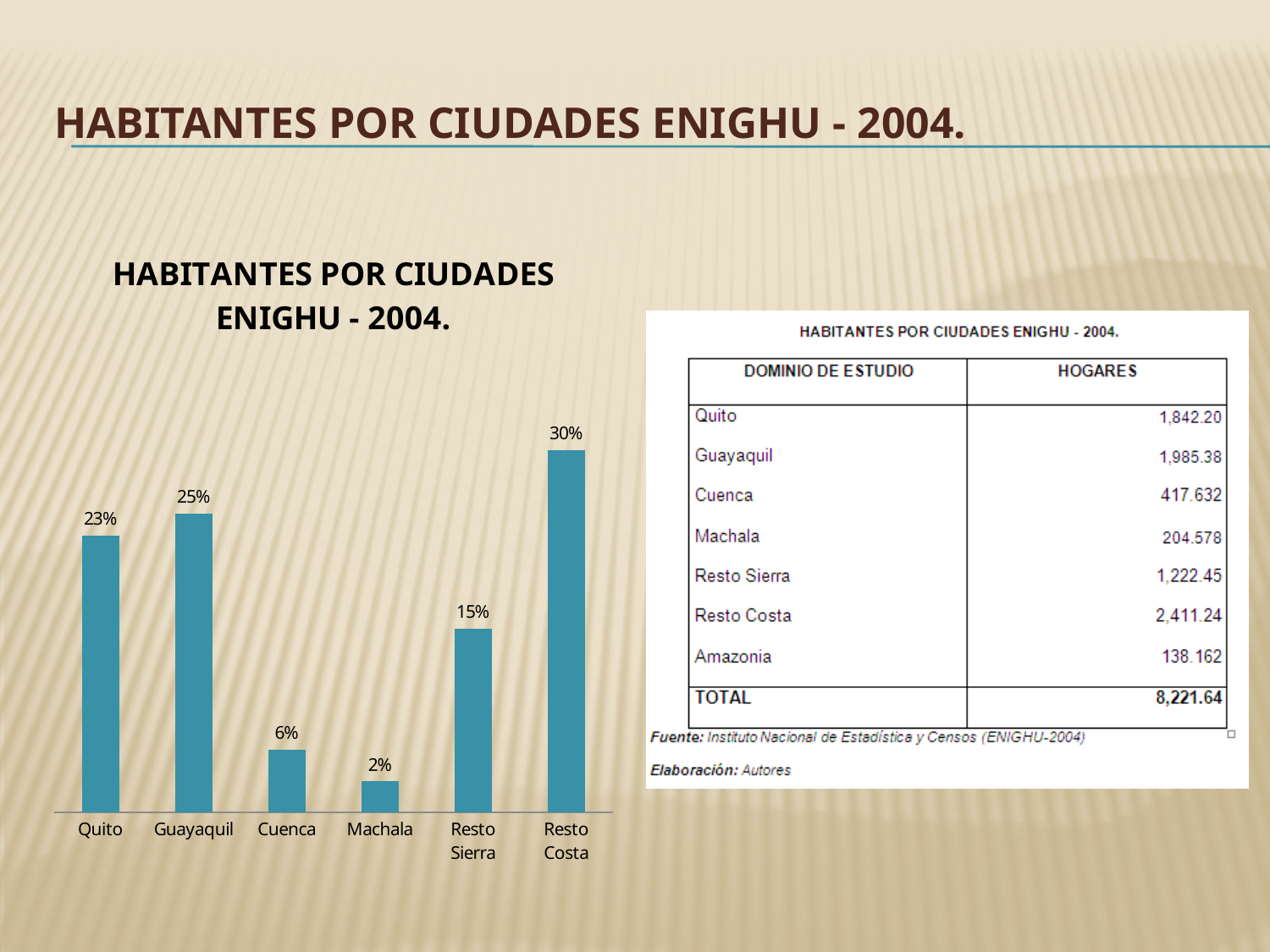
What is the value for Quito in the chart? 23% Which is larger, the value for Quito or the value for Guayaquil? Guayaquil What is the value for Cuenca in the chart? 6% Which category has the lowest value in the chart? Machala How many categories are shown in the chart? 6 What kind of chart is shown on the slide? Bar chart What is the value for Guayaquil in the chart? 25% Which category has the highest value in the chart? Resto Costa What is the value for Resto Sierra in the chart? 15% What is the difference between the values for Resto Costa and Resto Sierra? 15% What is the value for Machala in the chart? 2% What is the title of the chart? HABITANTES POR CIUDADES ENIGHU - 2004.